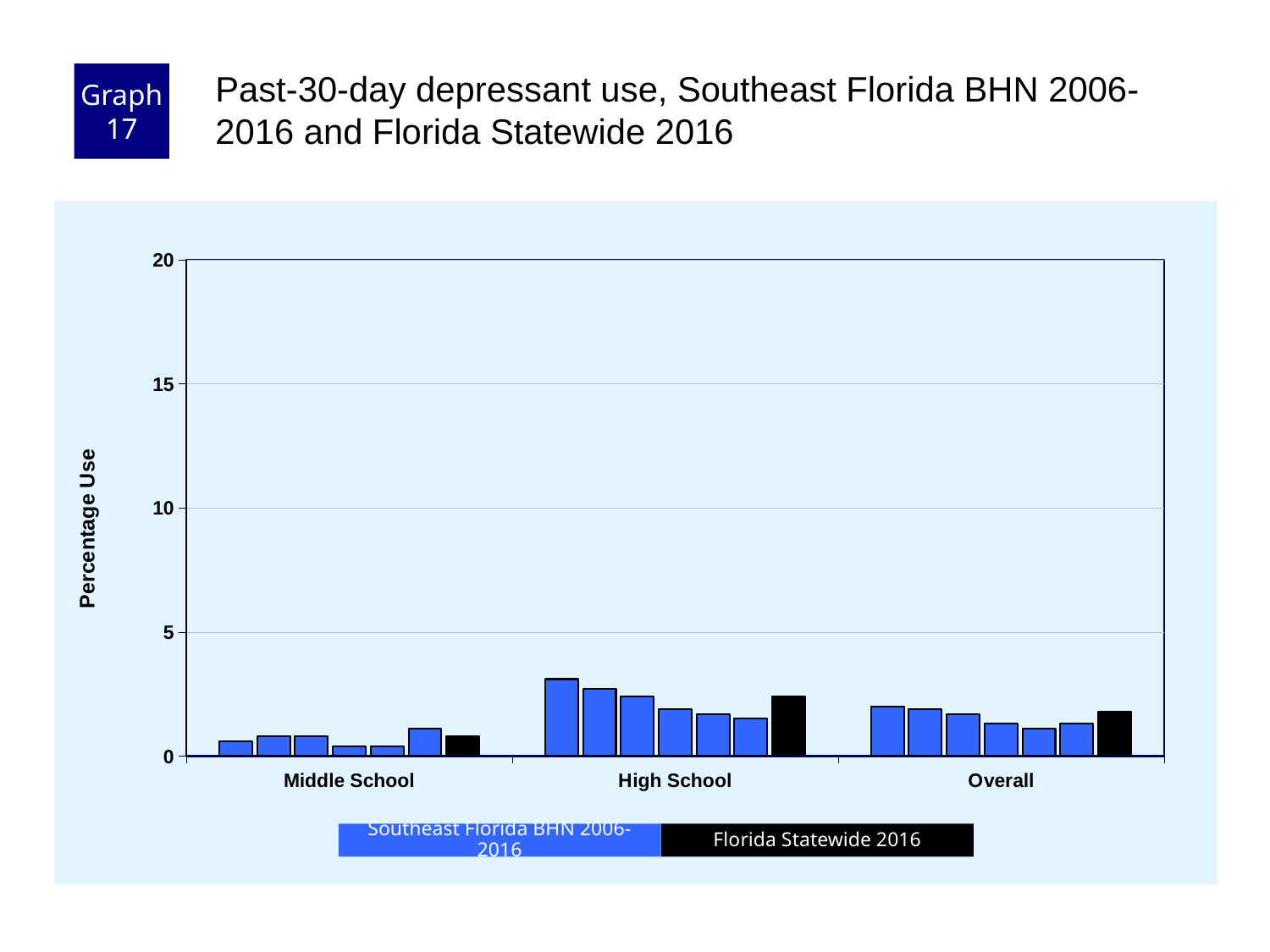
Is the Florida Statewide 2016 value larger for High School or for Middle School? High School Do the Southeast Florida BHN 2006-2016 bars for High School rise or fall from left to right? fall Which category has the tallest bar in the chart? High School Which category has the lowest bars in the chart? Middle School What kind of chart is shown on the slide? bar chart How many series does the legend list? 2 Is the Florida Statewide 2016 value larger for High School or for Overall? High School What is the label of the y axis? Percentage Use Is the Florida Statewide 2016 value for High School greater or less than 5? less What are the three categories on the x axis? Middle School, High School, Overall How many categories are shown on the x axis? 3 Is the Florida Statewide 2016 value for Middle School greater or less than 5? less